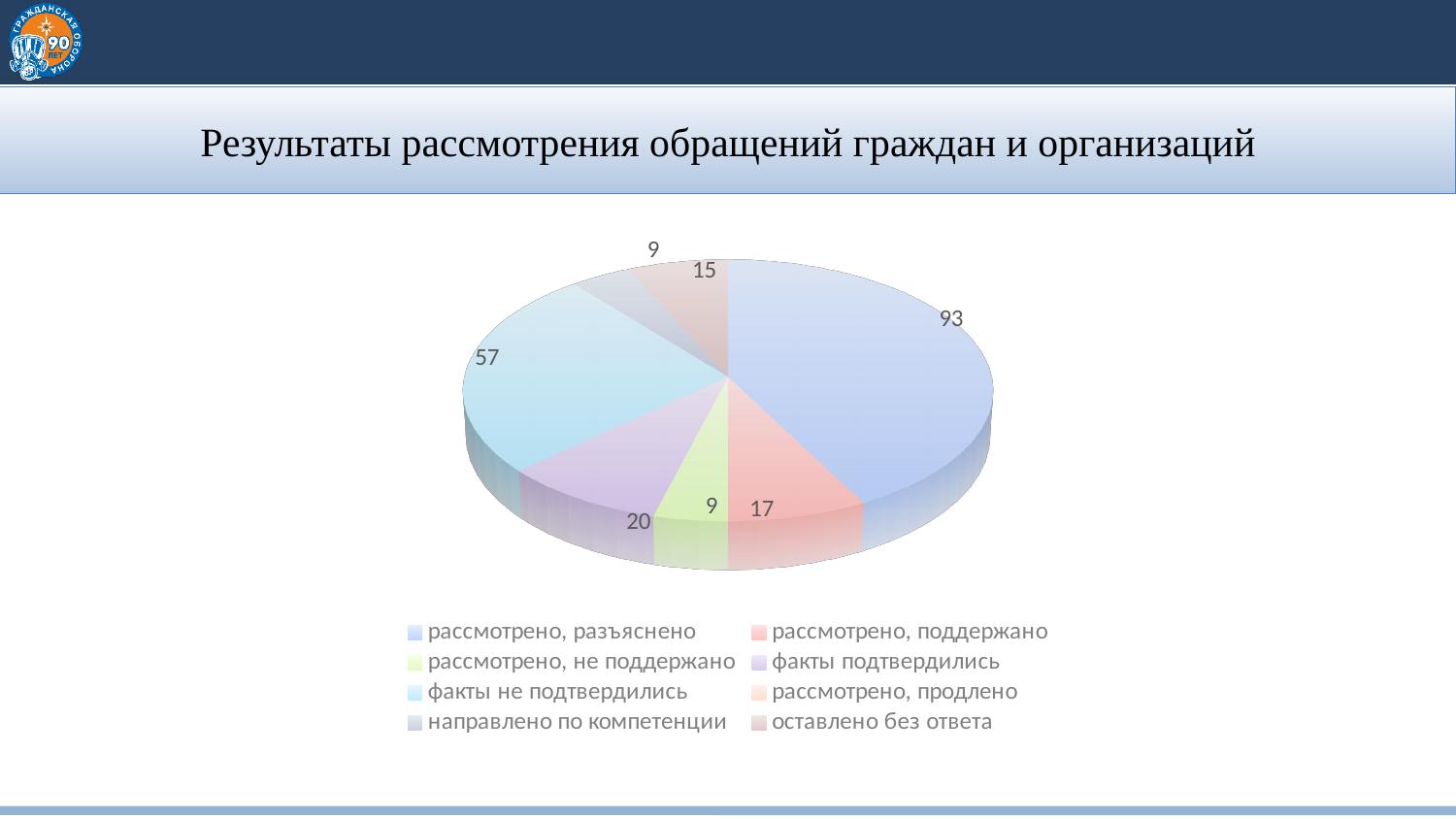
Which category has the largest slice of the pie? рассмотрено, разъяснено What is the value for "факты подтвердились"? 20 What is the difference between the values for "рассмотрено, разъяснено" and "факты не подтвердились"? 36 What is the value for "факты не подтвердились"? 57 Which is larger, the value for "факты подтвердились" or the value for "рассмотрено, поддержано"? факты подтвердились What is the value for "рассмотрено, разъяснено"? 93 What is the smallest value labelled on the pie chart? 9 What is the value for "рассмотрено, поддержано"? 17 What is the title of the chart on the slide? Результаты рассмотрения обращений граждан и организаций What is the value for "оставлено без ответа"? 15 How many entries does the legend list? 8 What kind of chart is shown on the slide? pie chart